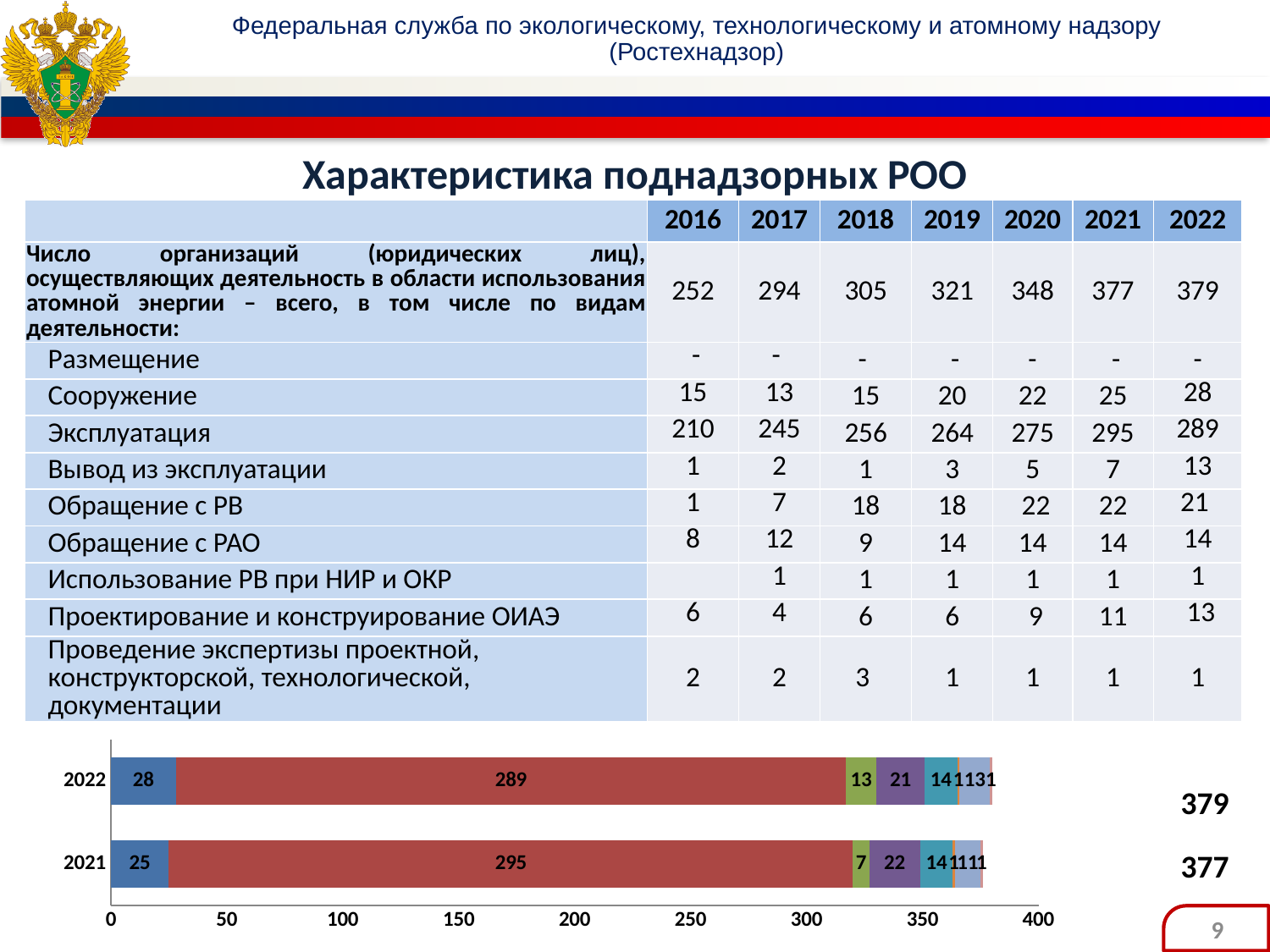
What is the highest value shown on the x axis of the chart? 400 In the chart, what is the value of the largest (red) segment of the 2021 bar? 295 In the chart, what is the value of the largest (red) segment of the 2022 bar? 289 In the chart, which bar has the larger total, 2022 or 2021? 2022 What kind of chart is shown at the bottom of the slide? Stacked bar chart What is the total shown for the 2021 bar in the chart? 377 In the chart, what is the difference between the totals of the 2022 and 2021 bars? 2 How many bars (years) does the chart at the bottom of the slide show? 2 What is the total shown for the 2022 bar in the chart? 379 In the chart, what is the value of the green segment of the 2021 bar? 7 In the chart, what is the value of the leftmost (blue) segment of the 2021 bar? 25 In the chart, what is the value of the leftmost (blue) segment of the 2022 bar? 28